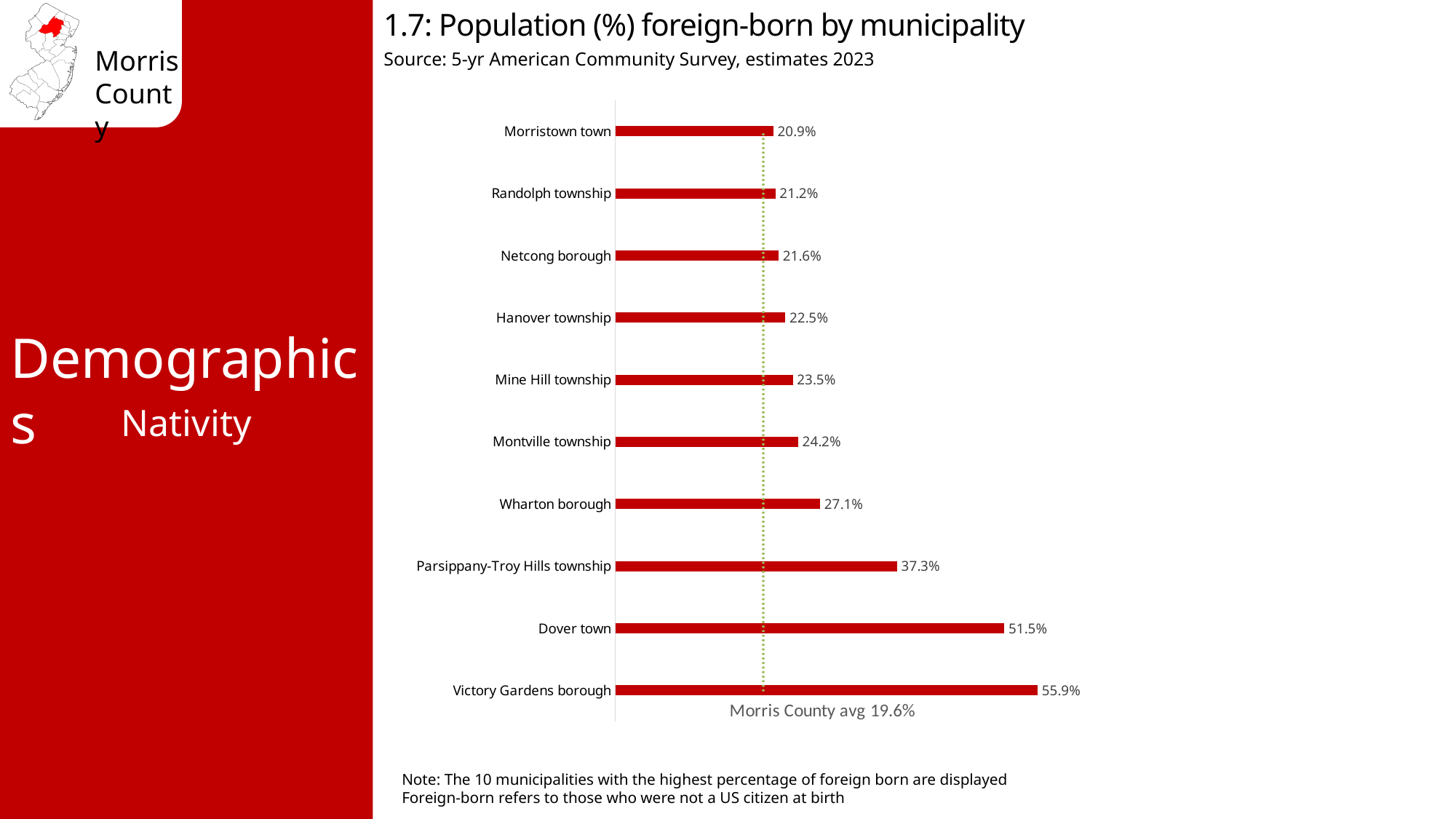
Which municipality has the lowest foreign-born population percentage shown on the chart? Morristown town What is the foreign-born population percentage for Dover town? 51.5% What kind of chart is shown on the slide? Bar chart Which has a higher foreign-born percentage, Mine Hill township or Netcong borough? Mine Hill township What is the difference in foreign-born percentage between Victory Gardens borough and Dover town? 4.4% What is the foreign-born population percentage for Hanover township? 22.5% Which municipality has the highest foreign-born population percentage? Victory Gardens borough What is the Morris County average foreign-born percentage indicated by the dotted line? 19.6% What is the source of the data shown in the chart? 5-yr American Community Survey, estimates 2023 What is the foreign-born population percentage for Parsippany-Troy Hills township? 37.3% What is the difference in foreign-born percentage between Wharton borough and Montville township? 2.9% How many municipalities are shown on the chart? 10